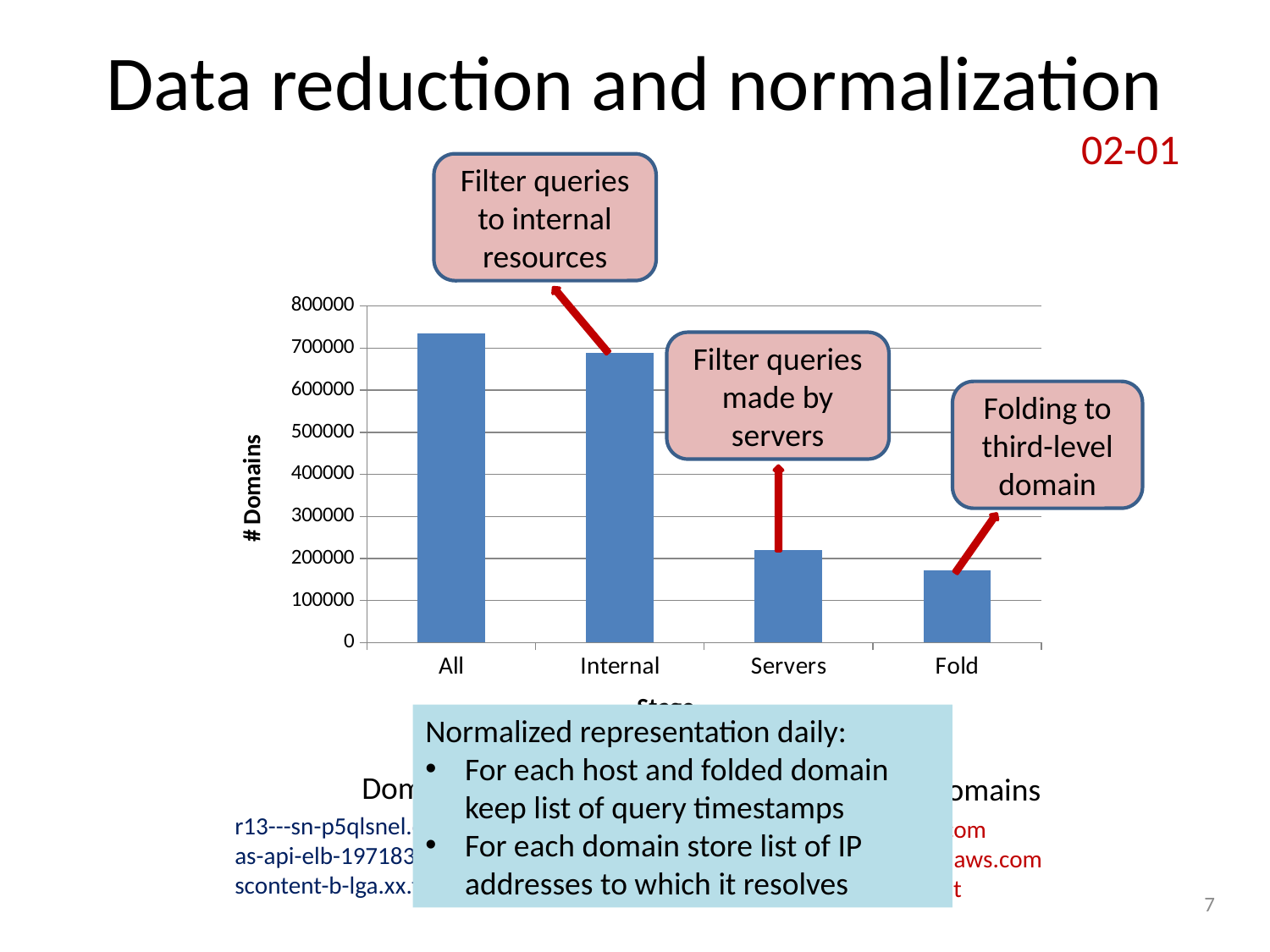
Is the value for Servers greater or less than 300000? less Is the value for Fold greater or less than 200000? less Which has more domains, Internal or Servers? Internal How many stages (categories) are plotted on the x axis of the chart? 4 Which has more domains, Servers or Fold? Servers Is the value for Internal greater or less than 600000? greater What is the label of the chart's y axis? # Domains Which stage has the lowest number of domains? Fold Which stage has the highest number of domains? All What kind of chart is shown on the slide? bar chart Do the values rise or fall moving from All to Fold along the x axis? fall